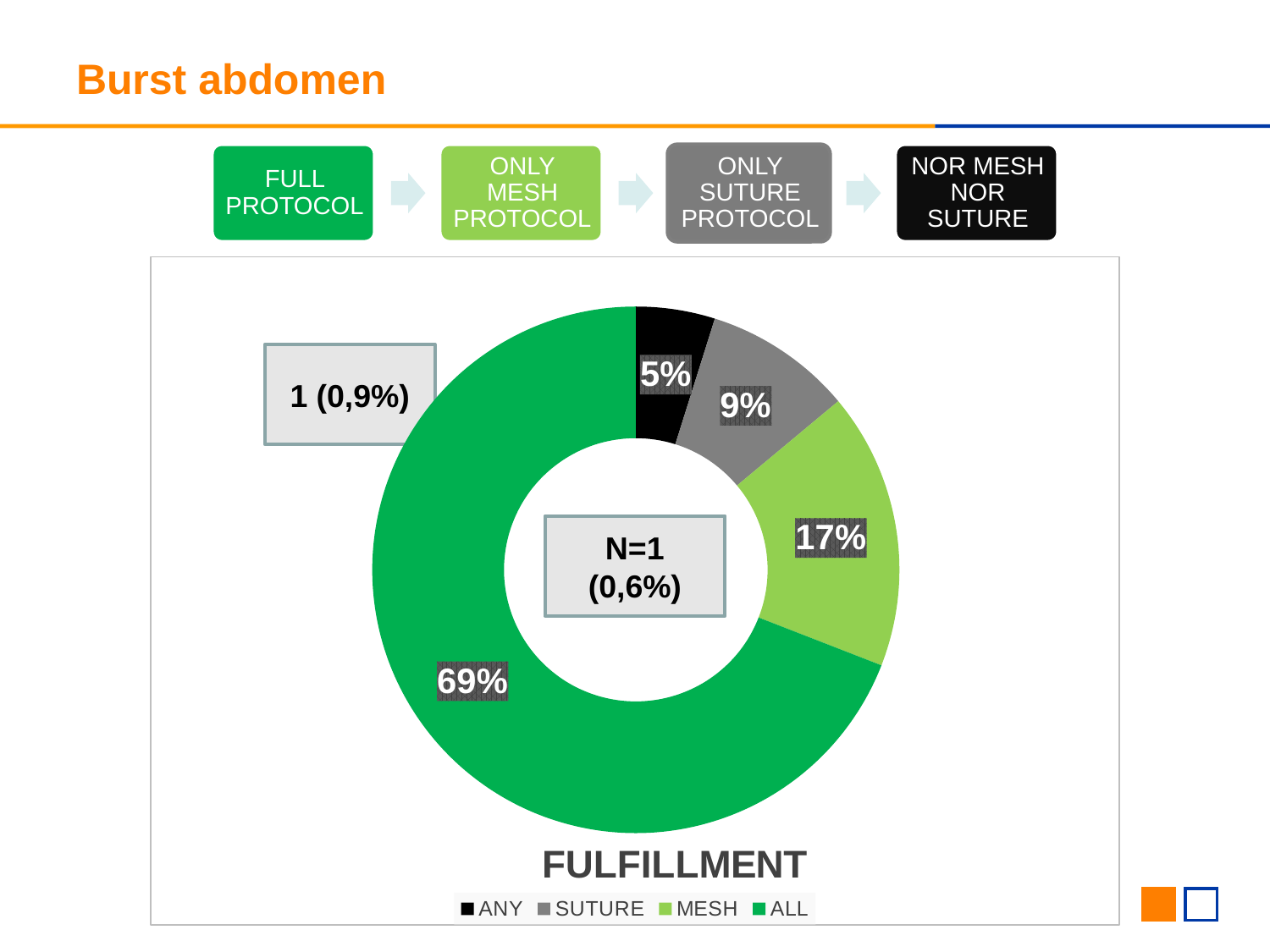
Which category has the largest share of the chart? ALL What percentage does the ANY slice represent? 5% Which is larger, the SUTURE slice or the MESH slice? MESH What kind of chart is shown on the slide? doughnut chart What percentage does the MESH slice represent? 17% What percentage does the SUTURE slice represent? 9% What is the difference in percentage points between the ALL and MESH slices? 52 Which category has the smallest share of the chart? ANY What is the title of the chart? FULFILLMENT What colour is the ANY slice in the chart? black What percentage does the ALL slice represent? 69% How many categories does the legend list? 4